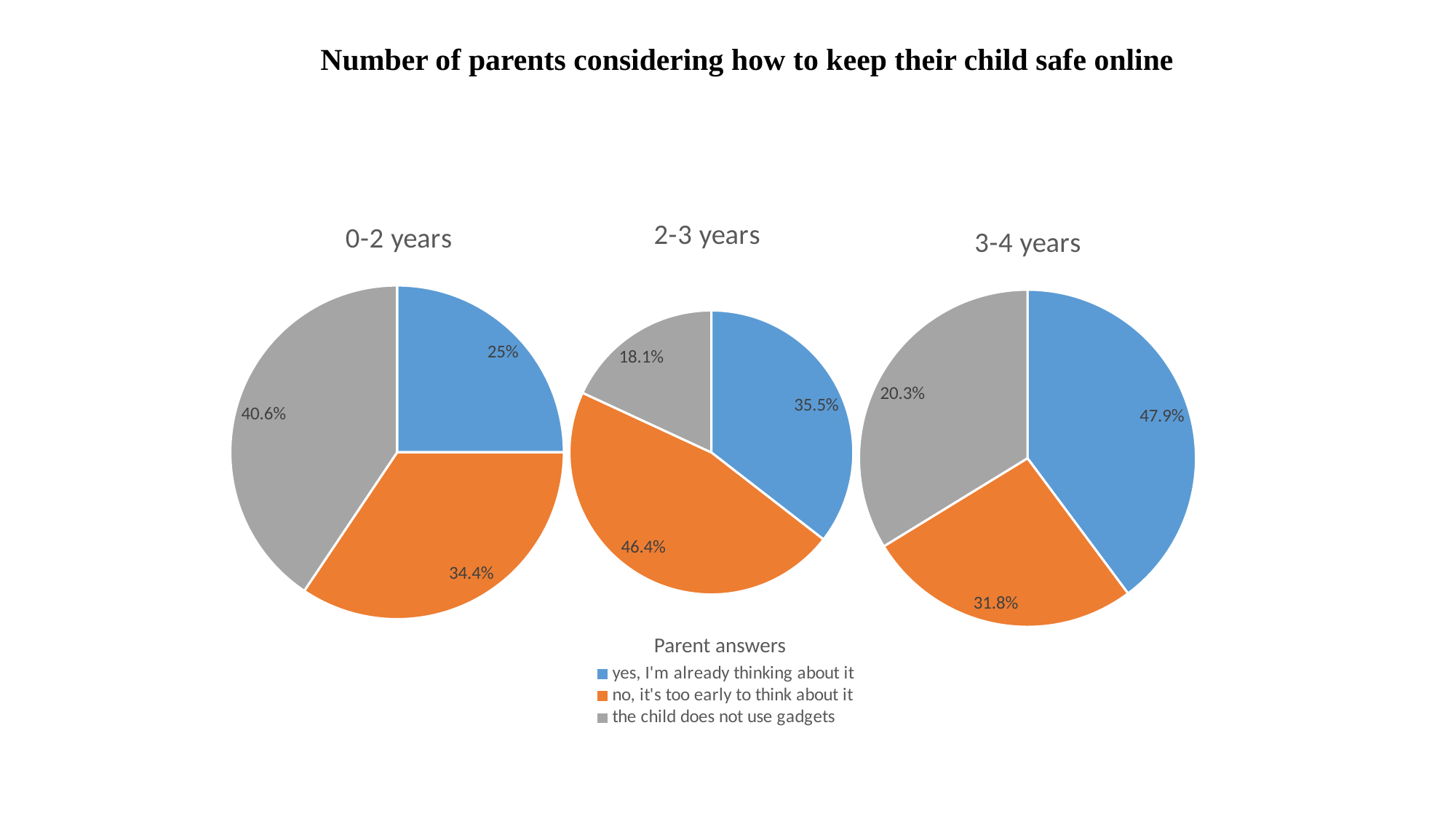
In the 0-2 years pie chart, which answer has the largest slice? the child does not use gadgets How many slices does each pie chart on the slide have? 3 In the 3-4 years pie chart, what share of parents answered "yes, I'm already thinking about it"? 47.9% In the 0-2 years pie chart, what is the value for "yes, I'm already thinking about it"? 25% In the 2-3 years pie chart, which answer has the smallest slice? the child does not use gadgets What kind of charts are shown on the slide? Pie charts In the 0-2 years pie chart, what share of parents answered "the child does not use gadgets"? 40.6% In the 3-4 years pie chart, which answer has the largest slice? yes, I'm already thinking about it In the 2-3 years pie chart, which is larger: the "yes, I'm already thinking about it" slice or the "no, it's too early to think about it" slice? no, it's too early to think about it What colour represents "the child does not use gadgets" in the legend? Grey In the 2-3 years pie chart, what share of parents answered "no, it's too early to think about it"? 46.4% In the 3-4 years pie chart, what is the difference between the "yes, I'm already thinking about it" slice and the "no, it's too early to think about it" slice? 16.1%